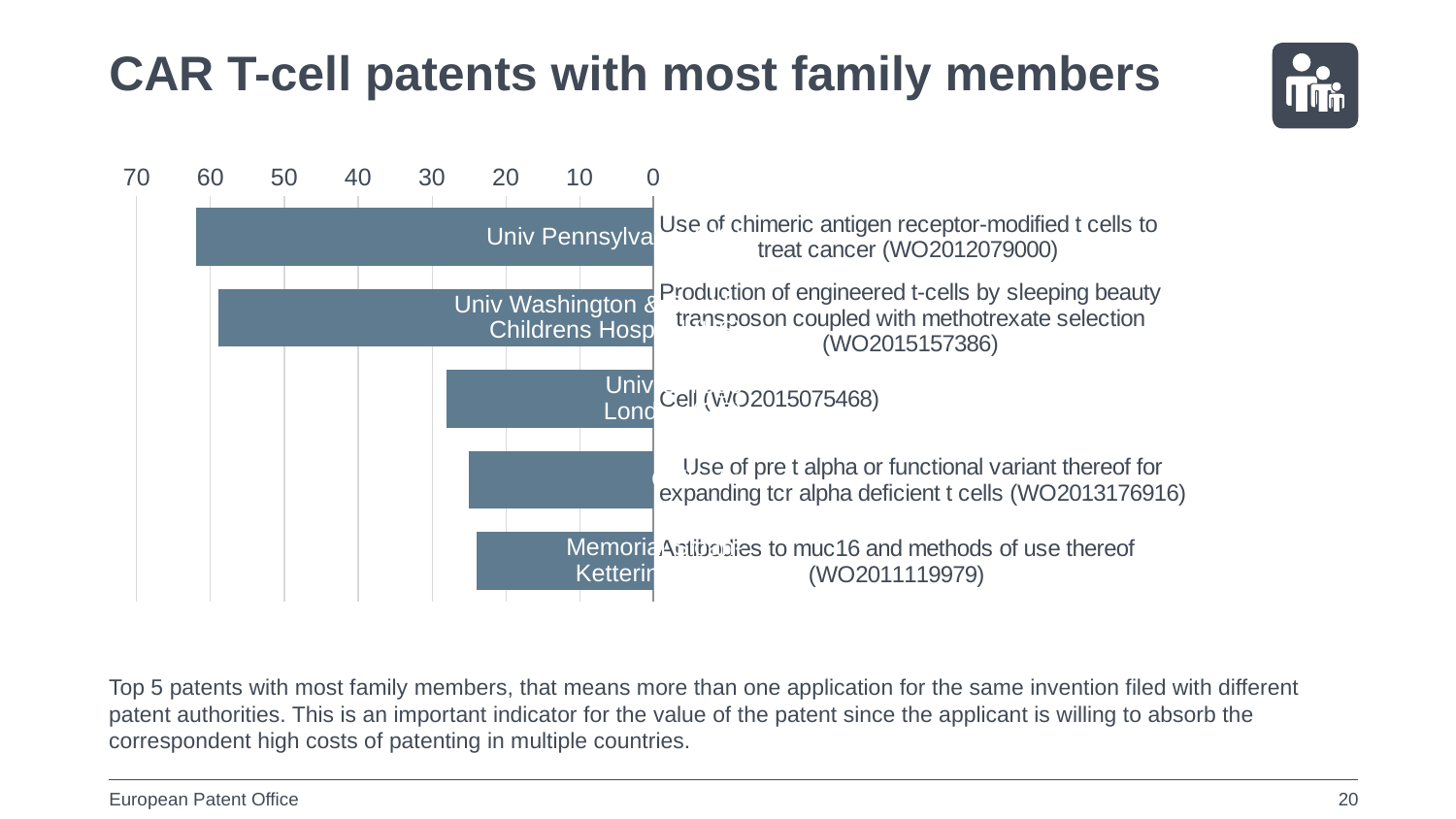
What kind of chart is shown on the slide? bar chart How many patents (bars) are shown in the chart? 5 Is the value for the Univ Washington & Childrens Hosp patent (WO2015157386) greater or less than 50? greater Which has more family members: the patent WO2015157386 or the patent WO2011119979? WO2015157386 Is the value for the patent WO2015075468 greater or less than 20? greater What is the highest value shown on the chart's axis? 70 Is the value for the Univ Pennsylvania patent (WO2012079000) greater or less than 50? greater What is the title of the slide containing the chart? CAR T-cell patents with most family members Which patent has the most family members in the chart? Use of chimeric antigen receptor-modified t cells to treat cancer (WO2012079000) Which applicant has the longest bar in the chart? Univ Pennsylvania